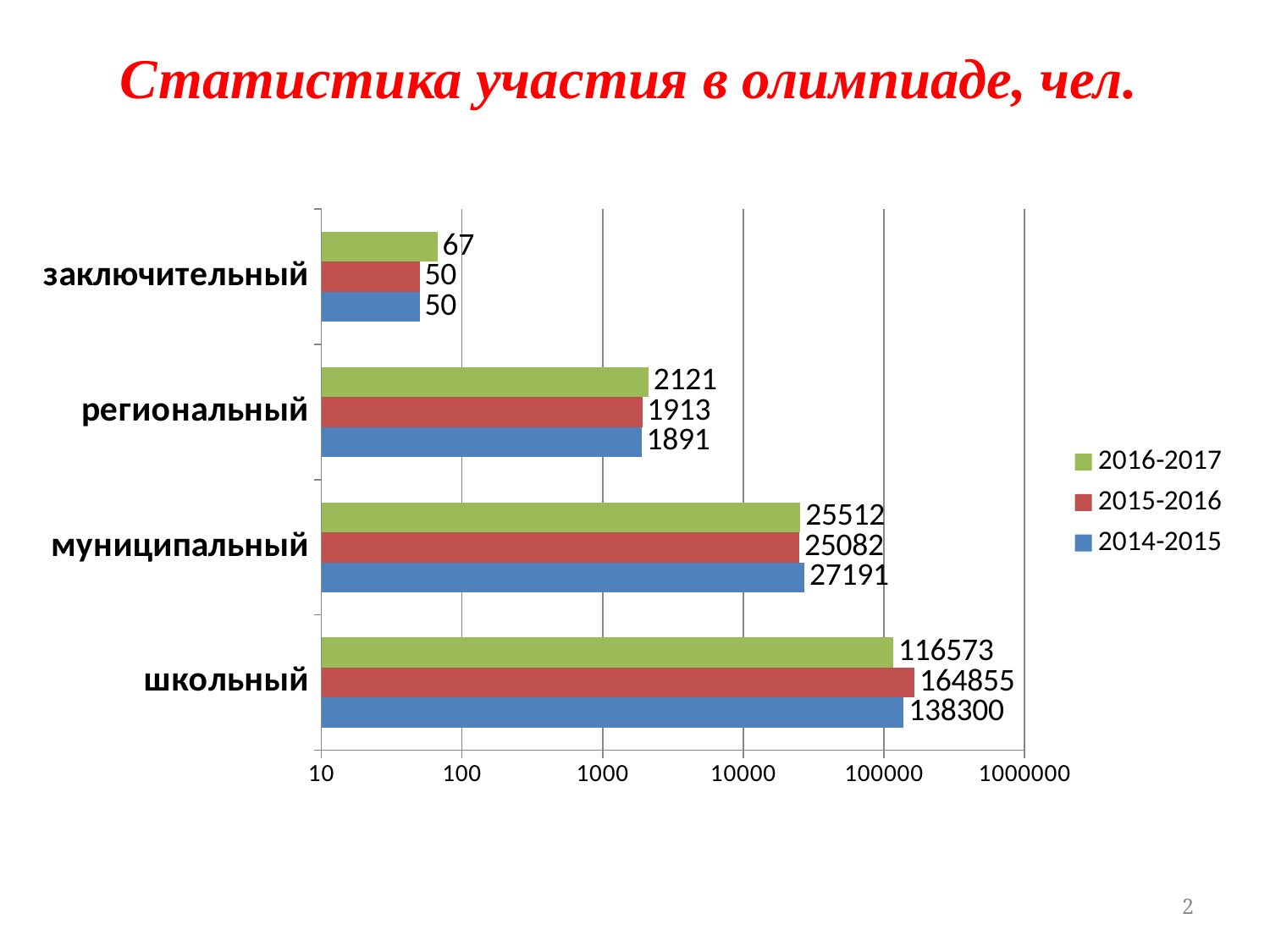
What is the value for муниципальный in the 2014-2015 series? 27191 What is the value for школьный in the 2015-2016 series? 164855 What is the value for региональный in the 2016-2017 series? 2121 What is the difference between the 2015-2016 and 2016-2017 values for школьный? 48282 What kind of chart is shown on the slide? bar chart How many categories are shown on the chart? 4 How many series does the legend list? 3 What is the value for заключительный in the 2016-2017 series? 67 Which category has the highest value in the 2016-2017 series? школьный Which category has the lowest value in the 2014-2015 series? заключительный What is the title of the chart? Статистика участия в олимпиаде, чел. Which is larger for муниципальный: the 2014-2015 value or the 2016-2017 value? 2014-2015